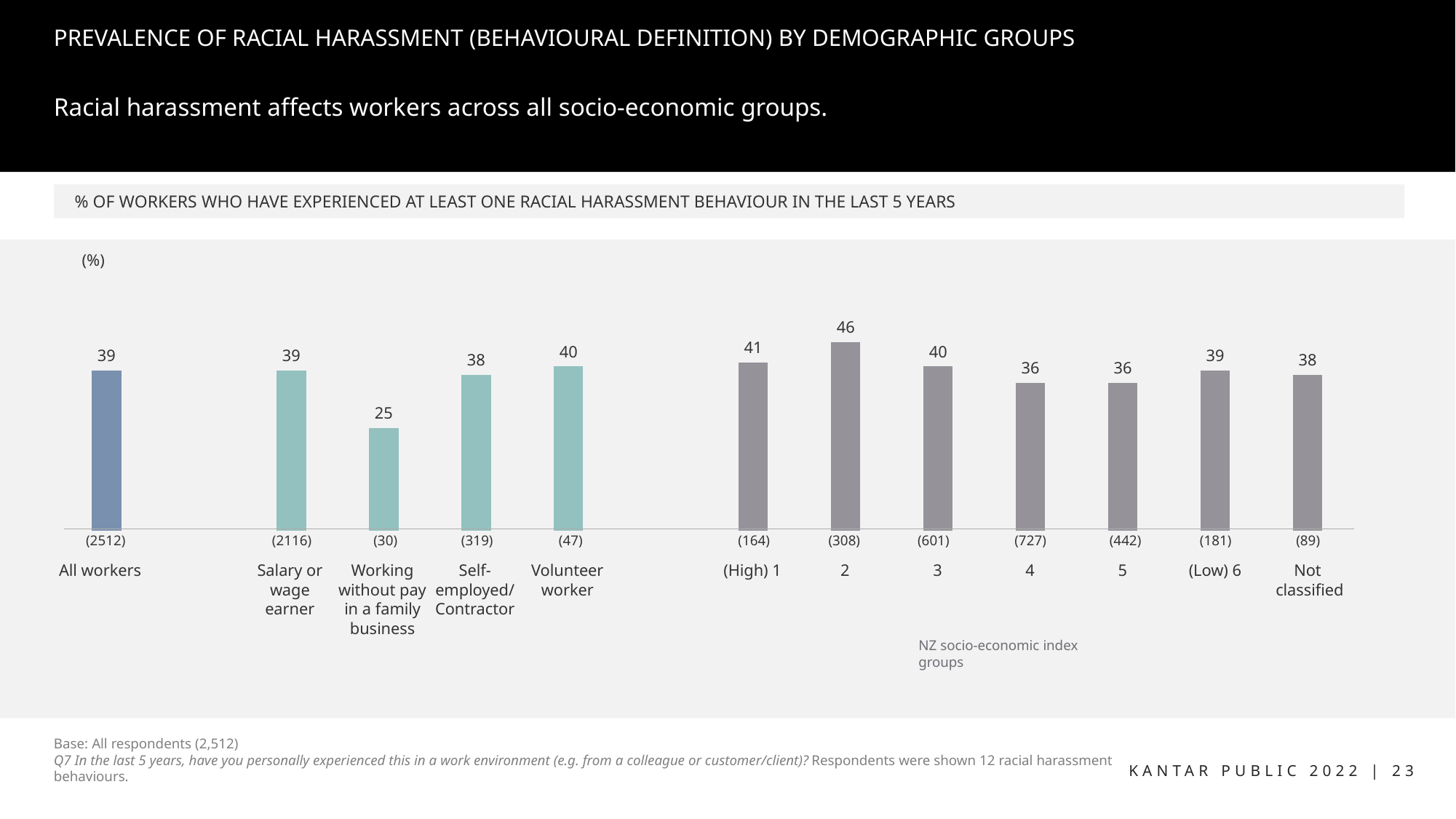
Which category has the lowest value? Working without pay in a family business How many bars are plotted on the chart? 12 Which category has the highest value? 2 What is the difference between the value for Volunteer worker and the value for Working without pay in a family business? 15 Which is larger, the value for (High) 1 or the value for (Low) 6? (High) 1 What is the base size shown under the All workers bar? (2512) What is the value for NZ socio-economic index group 2? 46 What is the value for All workers? 39 What is the value for Working without pay in a family business? 25 What is the value for Volunteer worker? 40 What kind of chart is shown on the slide? Bar chart What is the difference between the value for socio-economic group 2 and the value for socio-economic group 4? 10